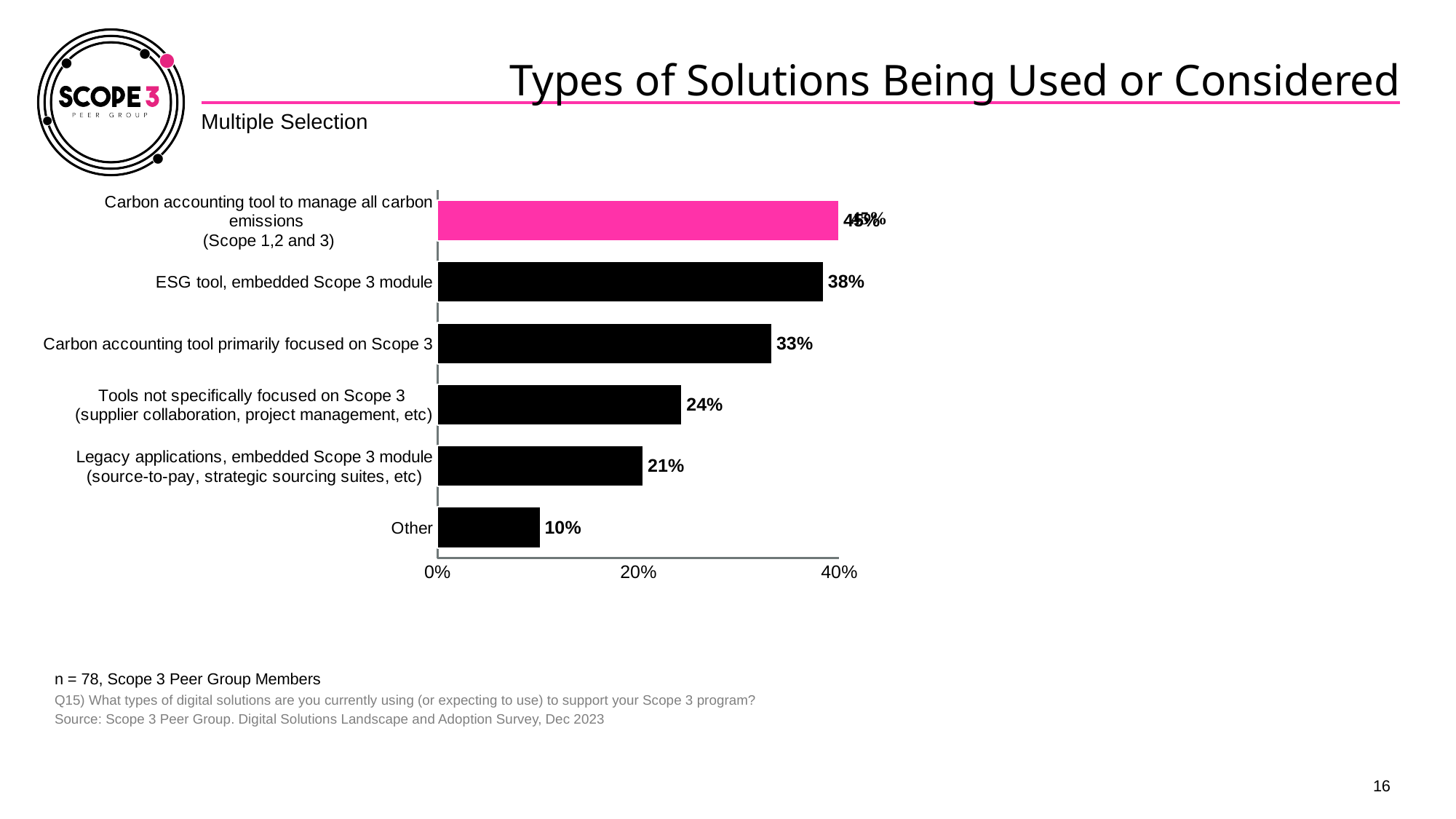
Which category has the highest value? Carbon accounting tool to manage all carbon emissions (Scope 1,2 and 3) Which is larger: the value for "Tools not specifically focused on Scope 3" or "Legacy applications, embedded Scope 3 module"? Tools not specifically focused on Scope 3 Which category has the lowest value? Other What type of chart is shown on the slide? bar chart What is the value for "ESG tool, embedded Scope 3 module"? 38% How many categories are shown in the chart? 6 Is the value for "Carbon accounting tool to manage all carbon emissions (Scope 1,2 and 3)" greater or less than 20%? greater What is the value for "Legacy applications, embedded Scope 3 module"? 21% What is the difference between the values for "ESG tool, embedded Scope 3 module" and "Other"? 28% What is the value for "Tools not specifically focused on Scope 3"? 24% What is the value for "Carbon accounting tool primarily focused on Scope 3"? 33% What is the value for "Other"? 10%